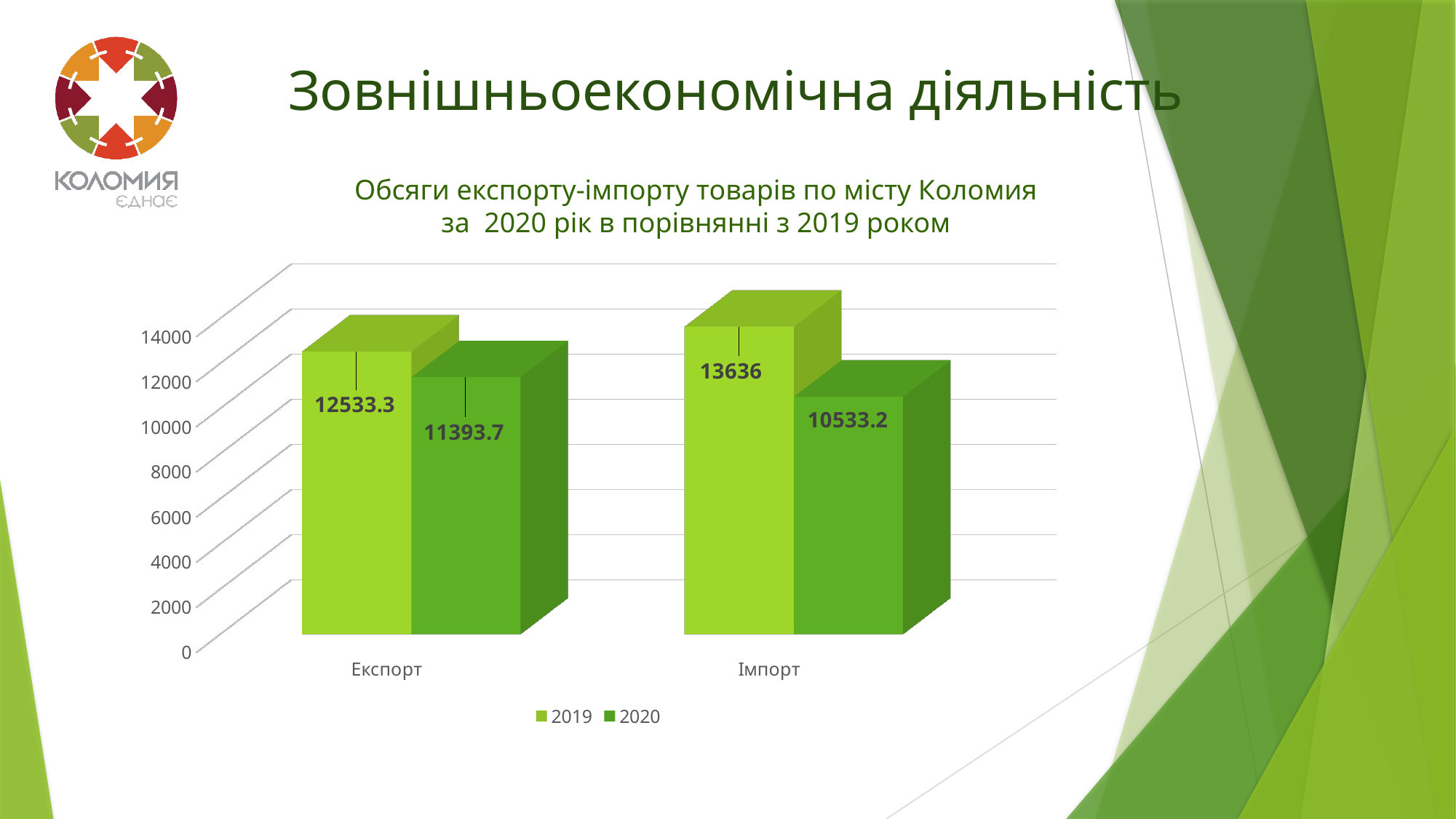
What is the value for Імпорт in 2019? 13636 Which bar has the highest value on the chart? Імпорт 2019 How many categories are shown on the x axis? 2 Which is larger, Експорт in 2020 or Імпорт in 2020? Експорт in 2020 How many series does the legend list? 2 What is the value for Експорт in 2020? 11393.7 What is the value for Експорт in 2019? 12533.3 Which bar has the lowest value on the chart? Імпорт 2020 What is the difference between the 2019 and 2020 values for Експорт? 1139.6 What is the value for Імпорт in 2020? 10533.2 What is the difference between the 2019 and 2020 values for Імпорт? 3102.8 What kind of chart is shown on the slide? Bar chart